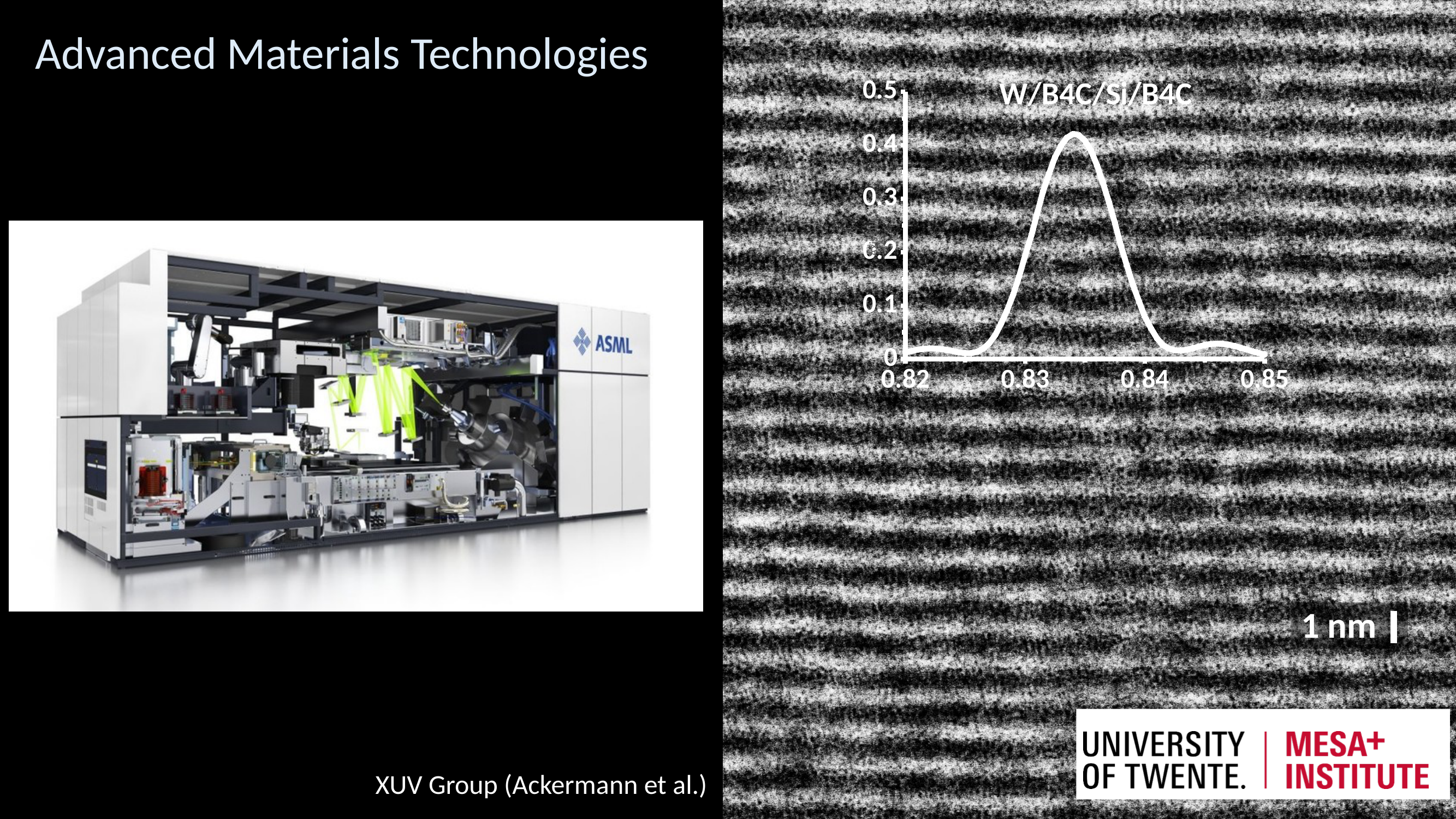
In the W/B4C/Si/B4C chart, is the value of the curve at x = 0.85 greater or less than 0.1? less What label is printed above the curve in the chart on the right? W/B4C/Si/B4C In the W/B4C/Si/B4C chart, is the curve higher at x = 0.83 or at x = 0.84? 0.83 How many curves are plotted in the W/B4C/Si/B4C chart? 1 What is the lowest value labelled on the x axis of the W/B4C/Si/B4C chart? 0.82 How many labelled tick values are shown on the x axis of the W/B4C/Si/B4C chart? 4 In the W/B4C/Si/B4C chart, is the peak value of the curve greater or less than 0.3? greater In the W/B4C/Si/B4C chart, between which two labelled x-axis values does the peak of the curve lie? 0.83 and 0.84 In the W/B4C/Si/B4C chart, does the curve rise or fall between x = 0.84 and x = 0.85? fall What is the highest value labelled on the y axis of the W/B4C/Si/B4C chart? 0.5 What kind of chart is overlaid on the image on the right side of the slide? line chart In the W/B4C/Si/B4C chart, is the value of the curve at x = 0.82 greater or less than 0.1? less